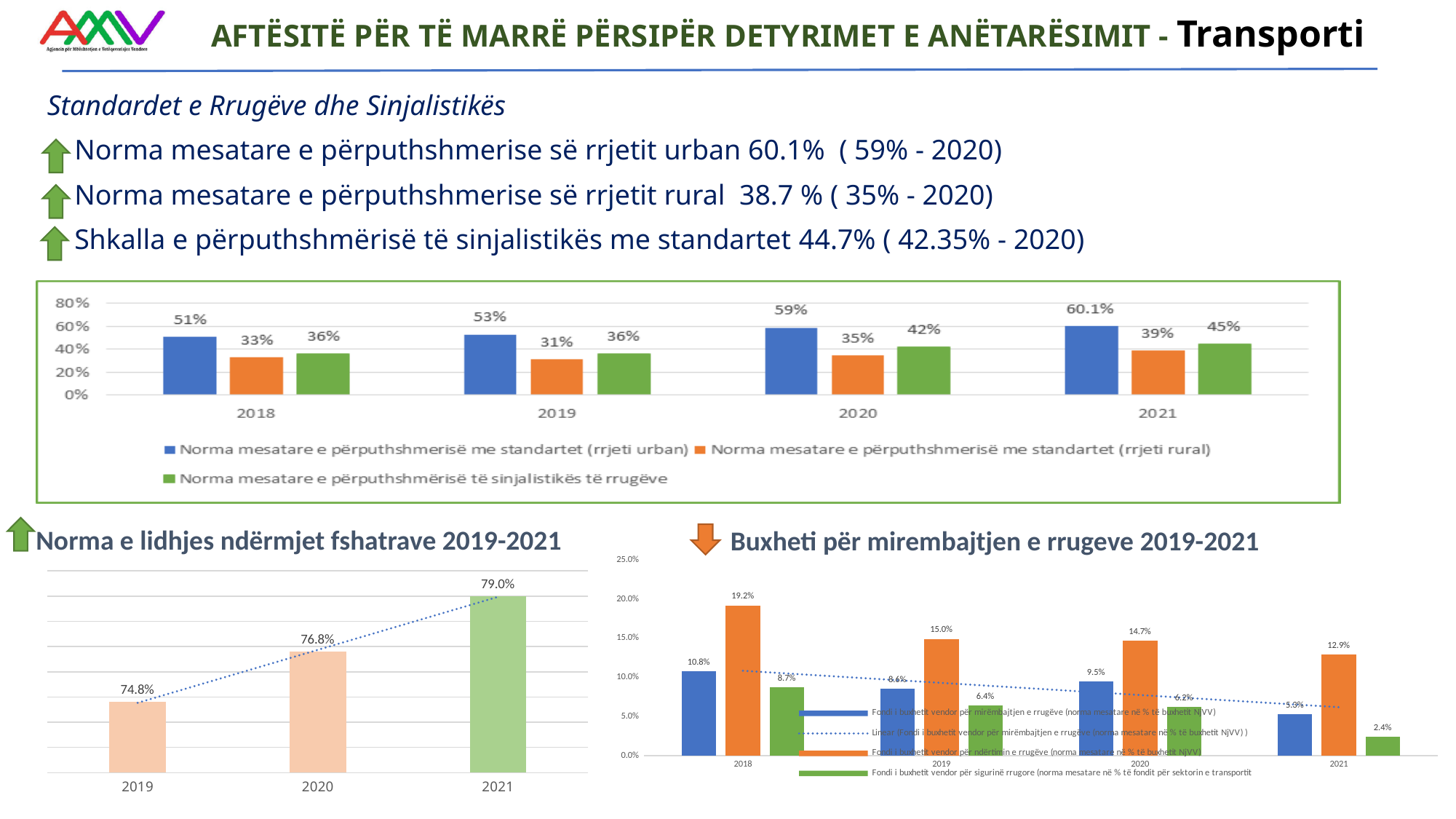
In the top chart, does the urban network series rise or fall from 2018 to 2021? rise In the top chart, what is the value for the urban network (rrjeti urban) series in 2021? 60.1% In the chart titled 'Buxheti për mirembajtjen e rrugeve 2019-2021', what is the value of the green bar in 2021? 2.4% In the top chart, what is the difference between the urban network value and the rural network value in 2018? 18% In the chart titled 'Buxheti për mirembajtjen e rrugeve 2019-2021', what is the value of the orange bar in 2018? 19.2% In the chart titled 'Norma e lidhjes ndërmjet fshatrave 2019-2021', what is the value for 2020? 76.8% In the chart titled 'Norma e lidhjes ndërmjet fshatrave 2019-2021', how many years are shown on the x axis? 3 In the top chart, what is the value for the rural network (rrjeti rural) series in 2019? 31% In the chart titled 'Norma e lidhjes ndërmjet fshatrave 2019-2021', which year has the highest value? 2021 In the top chart, what is the value for the road signage (sinjalistikës) series in 2020? 42% In the top chart, how many series does the legend list? 3 In the chart titled 'Buxheti për mirembajtjen e rrugeve 2019-2021', is the blue bar for 2018 greater or less than 10.0%? greater